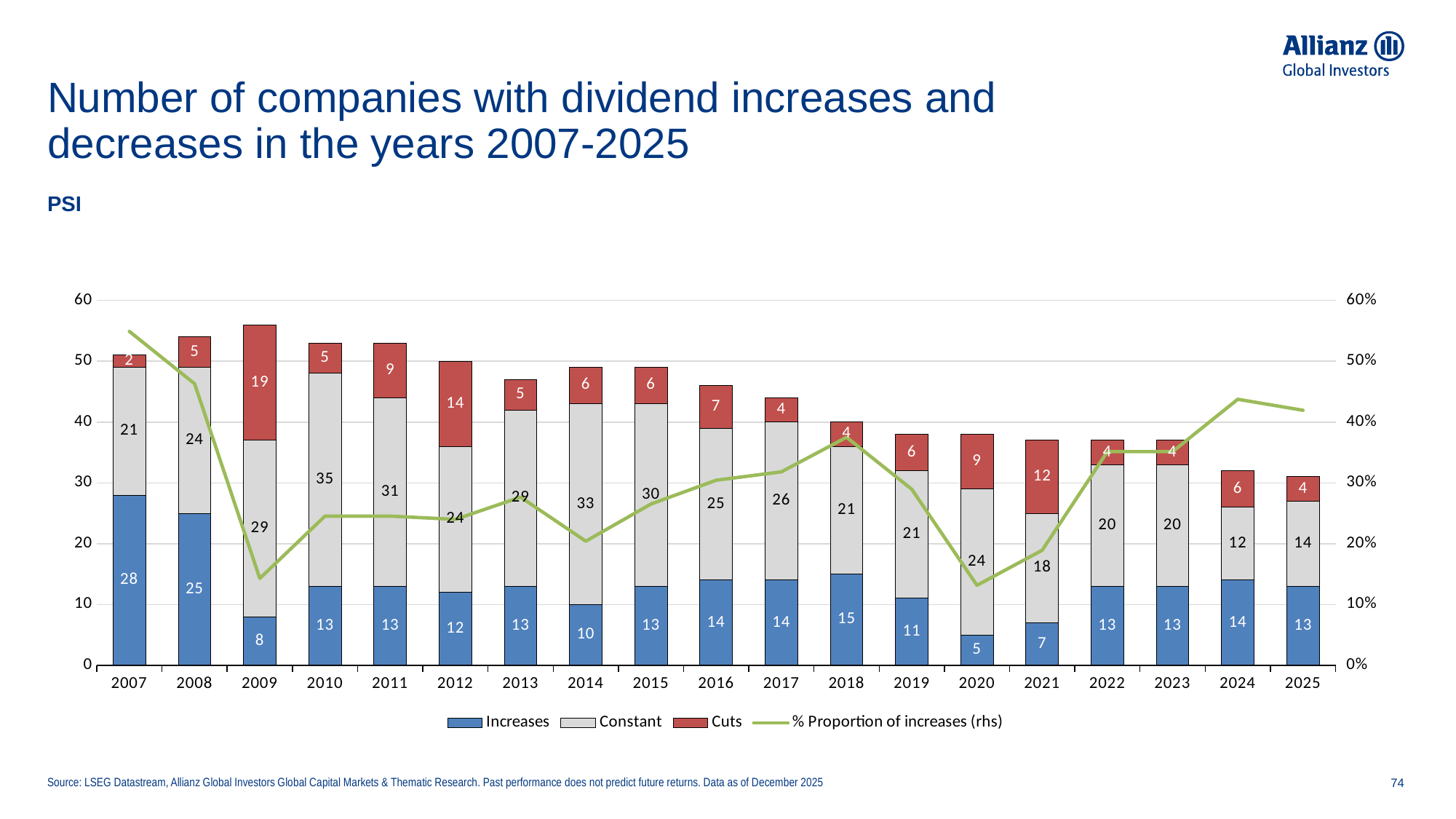
What is the Constant value for 2010? 35 How many years are shown on the x axis? 19 How many companies had dividend increases in 2007? 28 What is the total of the stacked bar for 2009? 56 What is the difference between the Increases values for 2007 and 2025? 15 Which year has the lowest value for Increases? 2020 How many series does the legend list? 4 What is the value of the Cuts series for 2009? 19 Which year has the highest value for Cuts? 2009 What kind of chart is shown on the slide? Stacked bar chart with a line Is the % Proportion of increases for 2020 greater or less than 20%? less Which is larger, the Cuts value for 2021 or the Cuts value for 2022? 2021